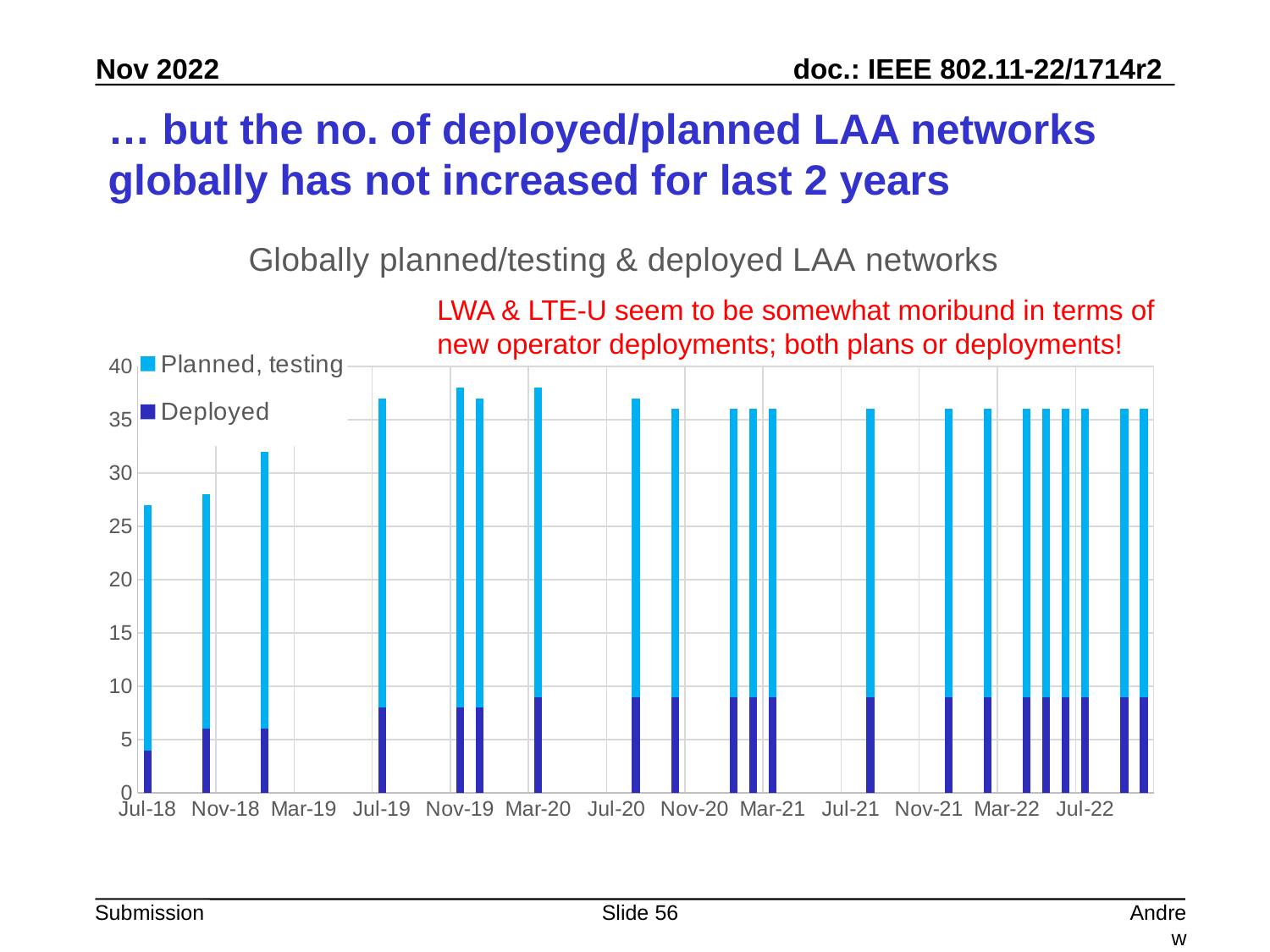
Is the Deployed value for Jul-22 greater or less than 10? less Which series is shown in dark blue at the bottom of each bar? Deployed Is the total height of the Jul-19 bar greater or less than 35? greater What kind of chart is shown on the slide? Stacked bar chart Is the Deployed value for Jul-18 greater or less than 10? less How many series does the chart legend list? 2 Which bar is taller in total, Jul-18 or Jul-19? Jul-19 Does the total number of networks rise or fall from Jul-18 to Jul-19? rise What is the title of the chart? Globally planned/testing & deployed LAA networks